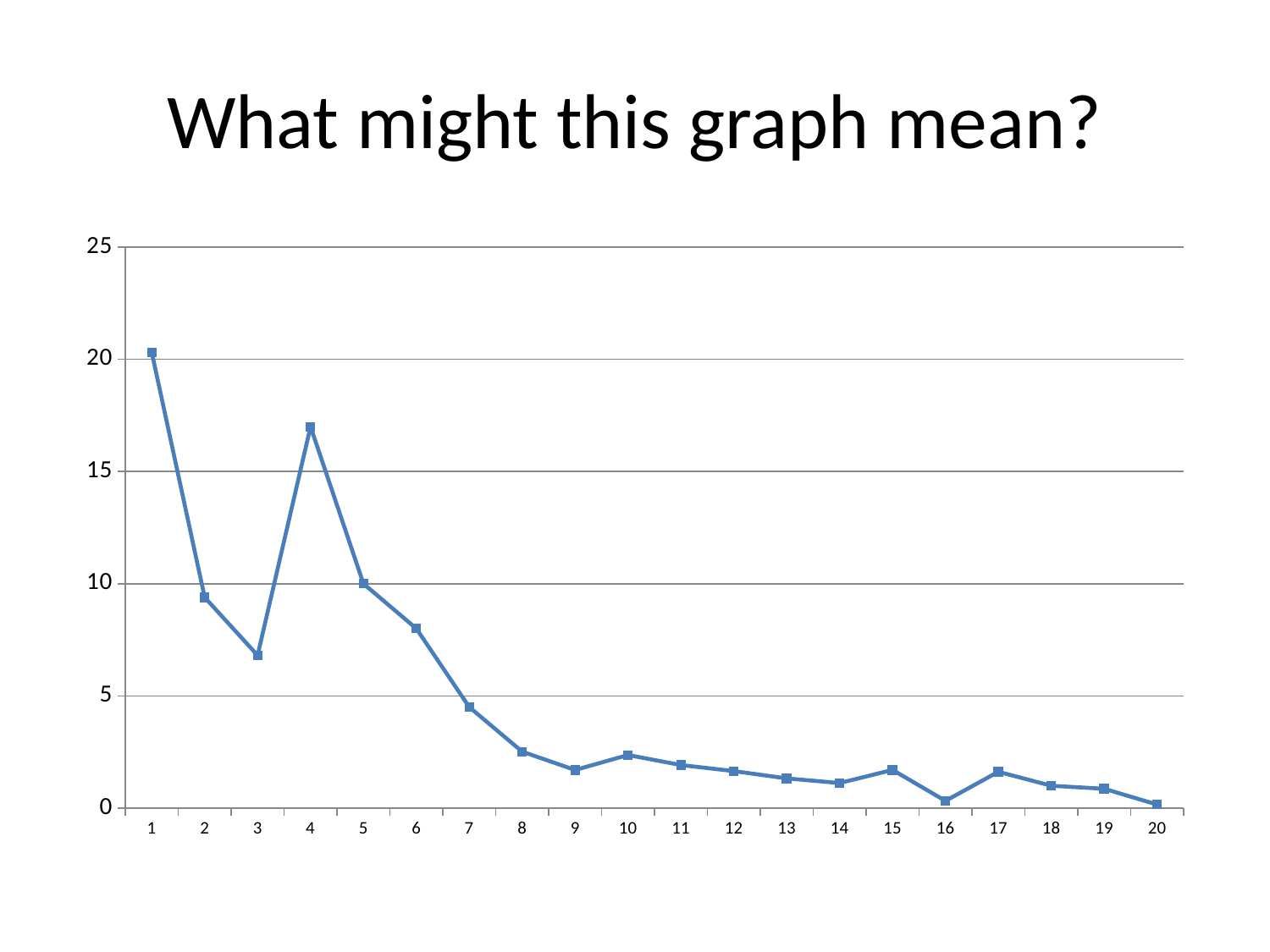
Is the value at x = 7 greater or less than 5? less Is the value at x = 6 greater or less than 5? greater What kind of chart is shown on the slide? line chart Overall, do the values rise or fall from x = 1 to x = 20? fall How many points are plotted along the x axis? 20 What is the title of the slide containing the chart? What might this graph mean? Is the value at x = 4 greater or less than 15? greater Which has the larger value, x = 4 or x = 5? 4 Which has the larger value, x = 2 or x = 3? 2 Which x-axis category has the highest value? 1